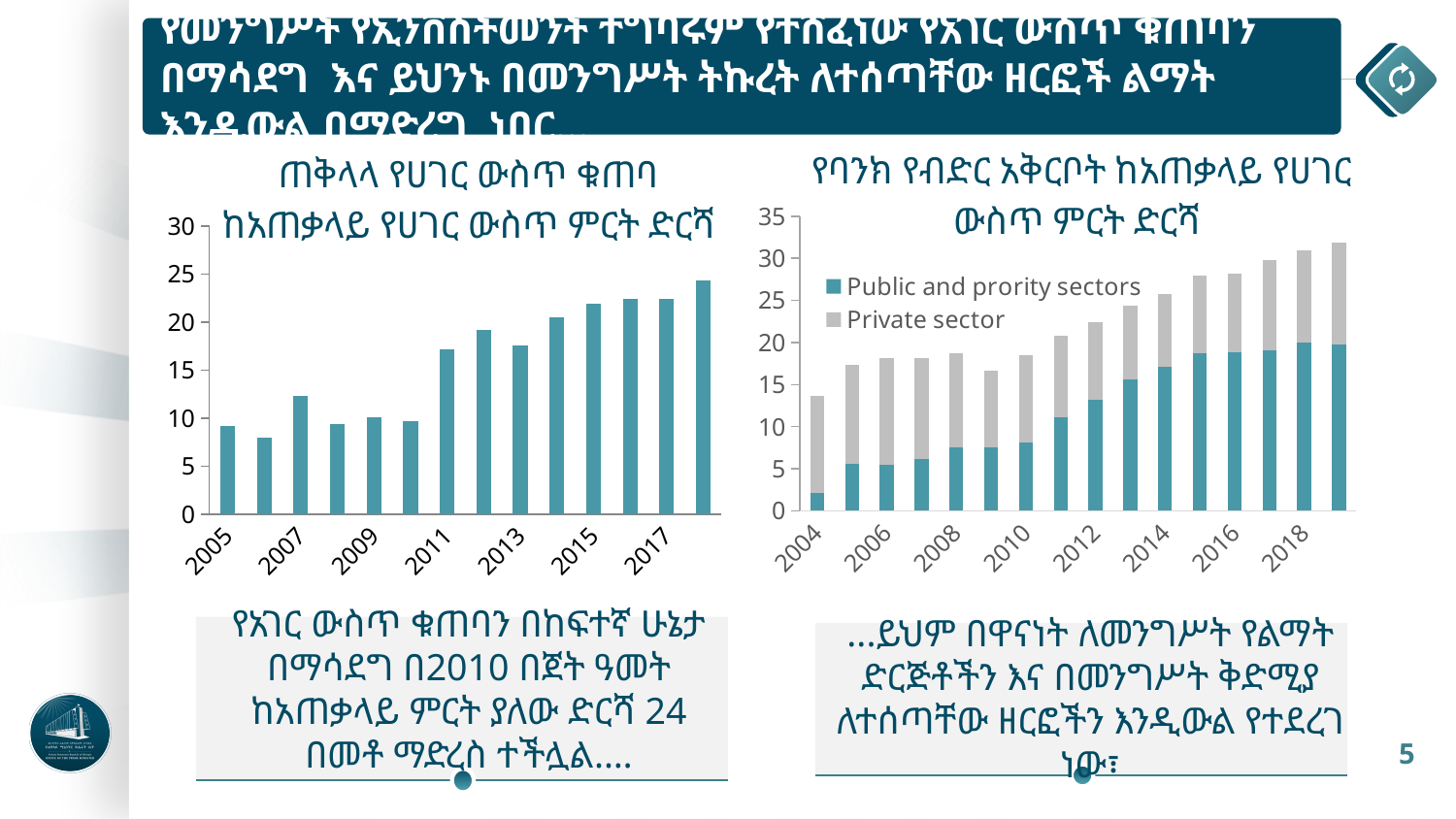
In the right chart, is the total stacked value for 2004 greater or less than 15? less What kind of chart is the right chart on the slide? stacked bar chart What kind of chart is the left chart on the slide? bar chart In the right chart, which year has the tallest stacked bar? 2019 In the left chart, which year has the highest bar? 2018 What are the two legend entries of the right chart? Public and prority sectors; Private sector In the left chart, do the values generally rise or fall from 2005 to 2018? rise In the right chart, which is larger: the total for 2019 or the total for 2004? 2019 In the left chart, which year has the lowest bar? 2006 In the left chart, is the value for 2005 greater or less than 10? less How many series does the legend of the right chart list? 2 In the left chart, is the value for 2018 greater or less than 20? greater